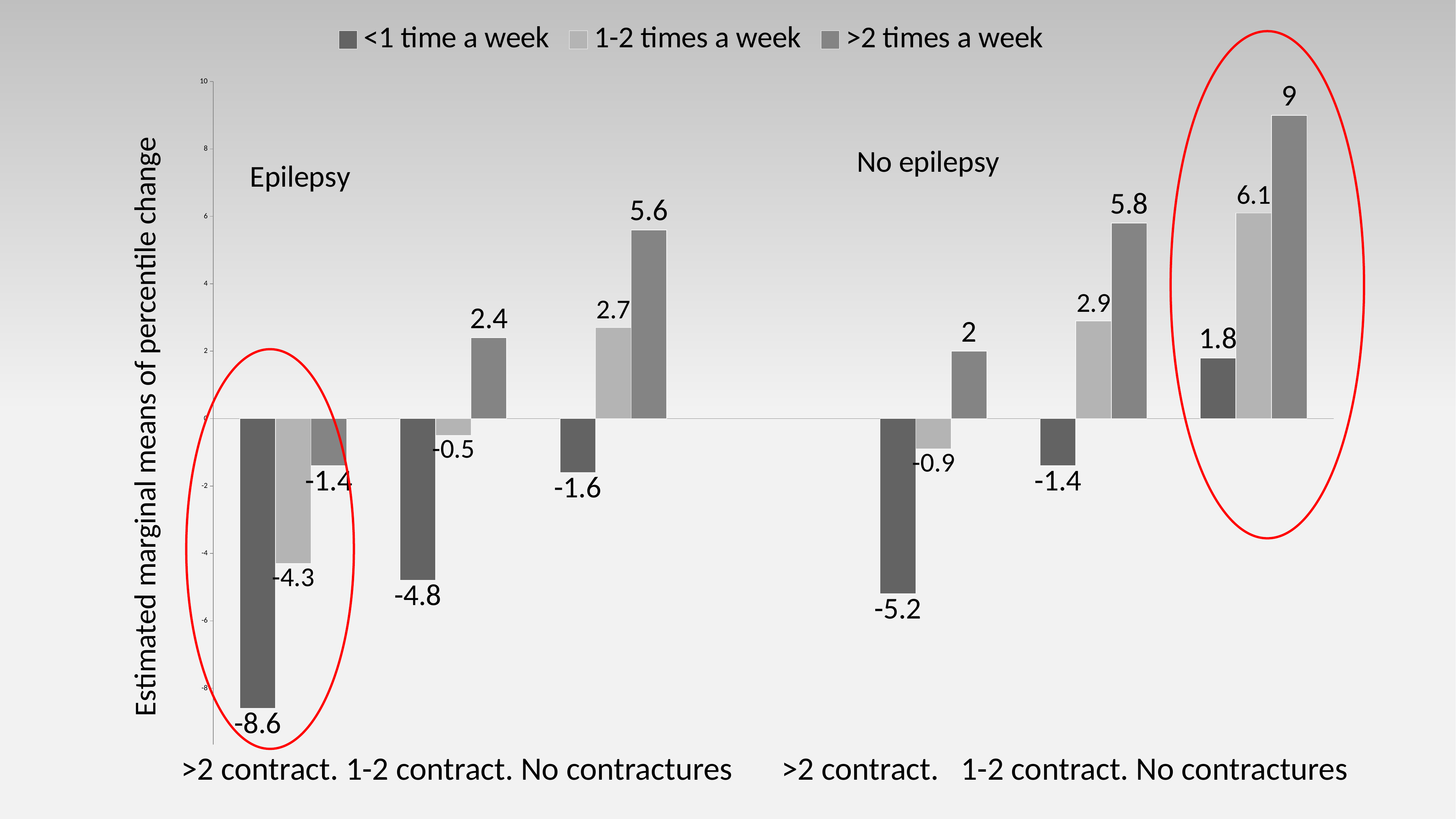
Which bar has the highest value on the chart? >2 times a week, No contractures, No epilepsy Which is larger: the '1-2 times a week' value for No contractures in the Epilepsy group or in the No epilepsy group? No epilepsy What is the difference between the '>2 times a week' value for No contractures in the No epilepsy group (9) and in the Epilepsy group (5.6)? 3.4 In the No epilepsy group, what is the value for '>2 times a week' in the 'No contractures' category? 9 In the Epilepsy group, what is the value for '1-2 times a week' in the '1-2 contract.' category? -0.5 In the No epilepsy group, what is the value for '<1 time a week' in the '>2 contract.' category? -5.2 How many series does the legend list? 3 What kind of chart is shown on the slide? bar chart In the Epilepsy group, what is the value for '<1 time a week' in the '>2 contract.' category? -8.6 Which bar has the lowest value on the chart? <1 time a week, >2 contract., Epilepsy What is the label of the vertical axis? Estimated marginal means of percentile change Within the Epilepsy group, do the '>2 times a week' values rise or fall going from '>2 contract.' to 'No contractures'? rise